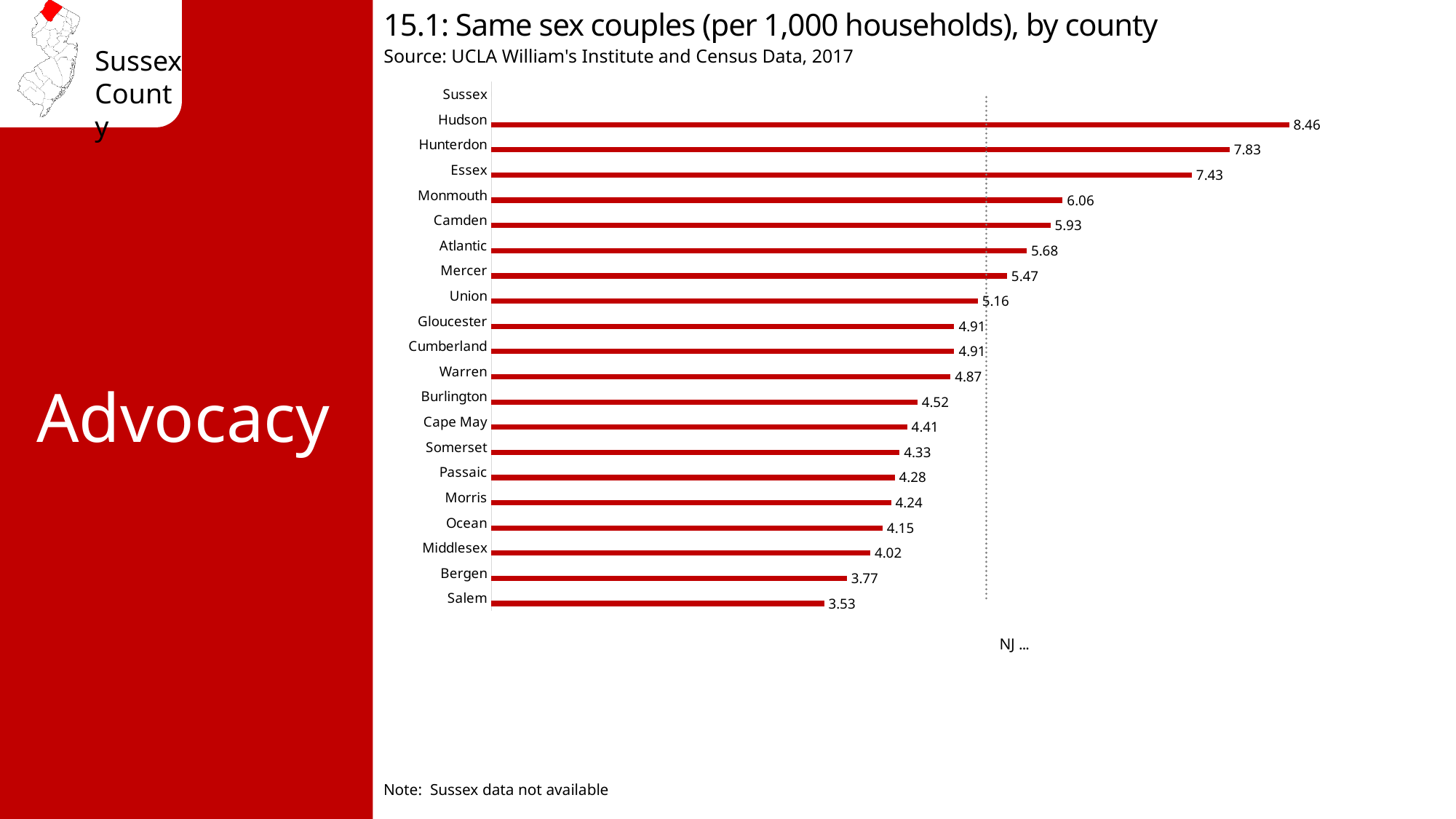
What is the difference between the values for Essex and Monmouth? 1.37 What is the value for Salem? 3.53 Which county has the highest value? Hudson Which county with a plotted bar has the lowest value? Salem What is the value for Warren? 4.87 What is the value for Cape May? 4.41 According to the note, which county's data is not available? Sussex What kind of chart is shown on the slide? Bar chart Which is larger, the value for Camden or the value for Atlantic? Camden What is the difference between the values for Hudson and Salem? 4.93 How many counties are listed on the category axis? 21 What is the value for Hudson? 8.46